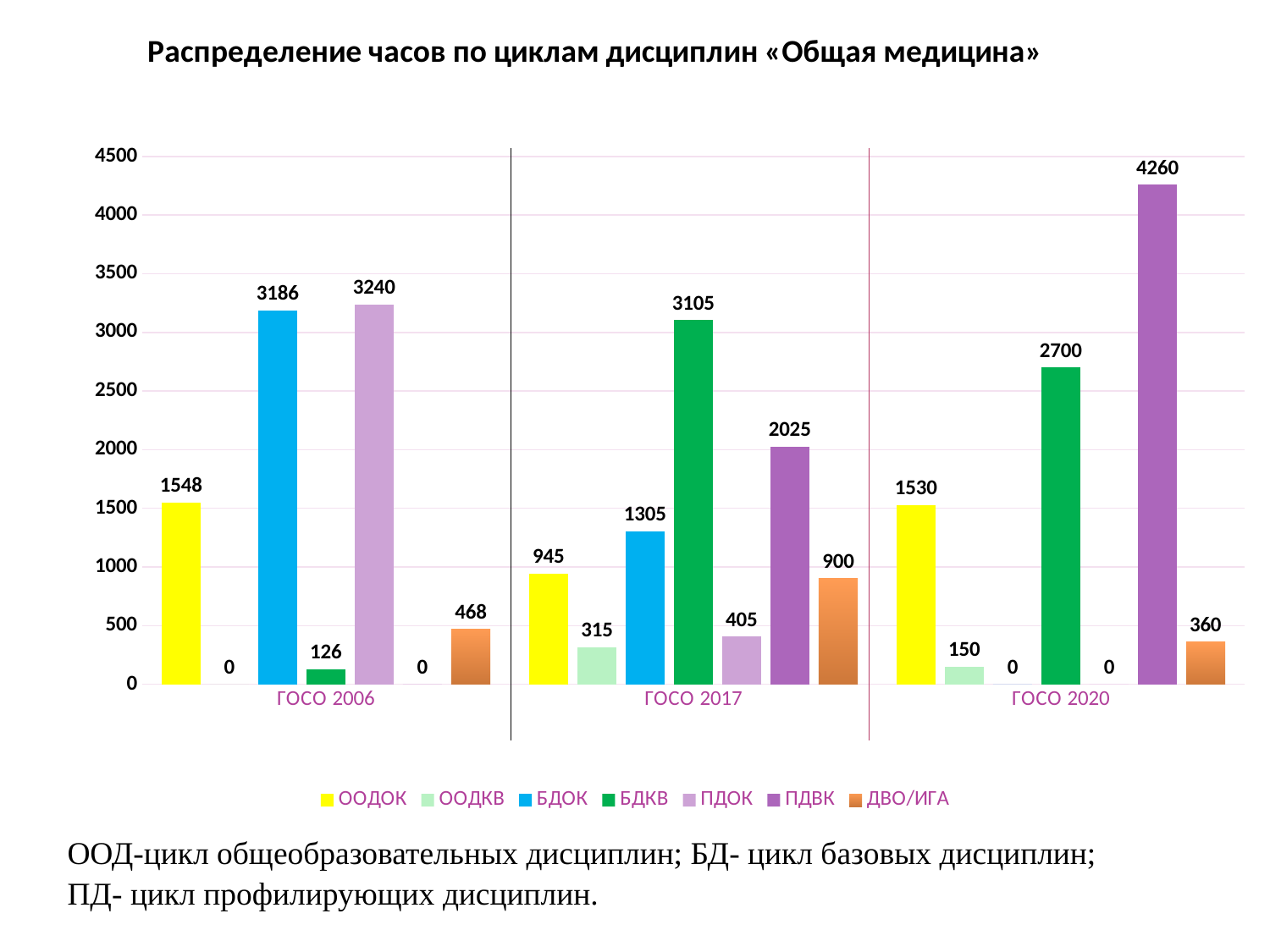
What is the value for БДОК in ГОСО 2006? 3186 What is the value for ДВО/ИГА in ГОСО 2017? 900 What kind of chart is shown on the slide? Bar chart By how much does the ПДВК value in ГОСО 2020 exceed the ПДВК value in ГОСО 2017? 2235 How many series does the legend list? 7 Does the ПДВК value rise or fall from ГОСО 2006 to ГОСО 2020? Rises Which is larger: the ООДОК value in ГОСО 2006 or in ГОСО 2020? ГОСО 2006 How many categories are shown on the x axis? 3 What is the value for ПДВК in ГОСО 2020? 4260 In which category is the ООДОК value the lowest? ГОСО 2017 Which series has the highest value in ГОСО 2017? БДКВ What is the difference between the ПДОК and БДОК values in ГОСО 2006? 54